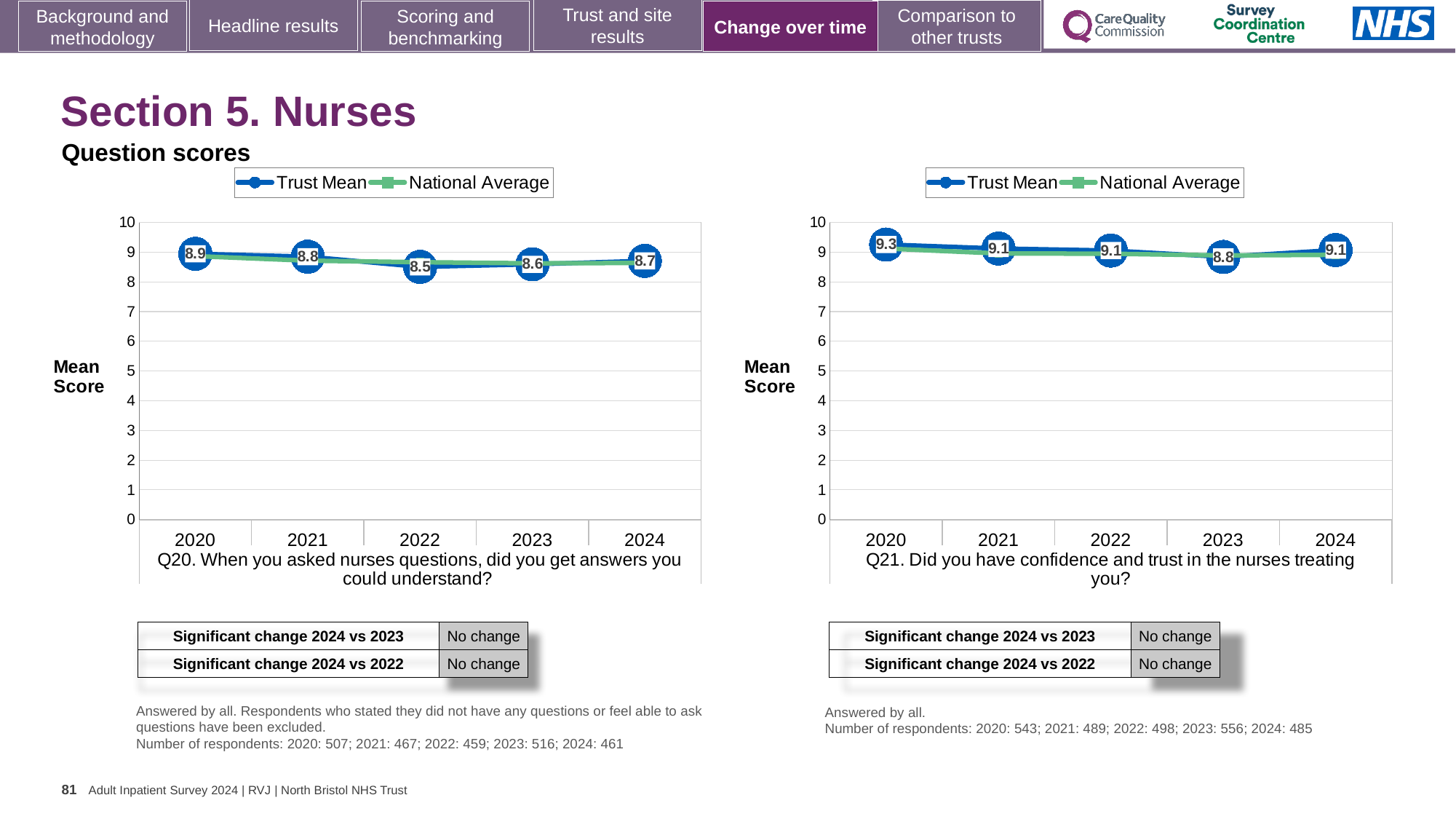
In the Q20 chart (left), which year has the lowest Trust Mean score? 2022 What type of chart is the Q21 chart (right)? Line chart How many series does the legend of the Q20 chart (left) list? 2 In the Q21 chart (right), what is the Trust Mean score for 2023? 8.8 In the Q20 chart (left), what is the difference between the Trust Mean scores for 2020 and 2022? 0.4 In the Q20 chart (left), what is the Trust Mean score for 2020? 8.9 In the Q21 chart (right), what is the Trust Mean score for 2020? 9.3 In the Q20 chart (left), which year has the highest Trust Mean score? 2020 In the Q21 chart (right), which year has the lowest Trust Mean score? 2023 In the Q20 chart (left), what is the Trust Mean score for 2022? 8.5 In the Q21 chart (right), is the Trust Mean score for 2020 or 2023 higher? 2020 In the Q21 chart (right), how many years are plotted on the x axis? 5